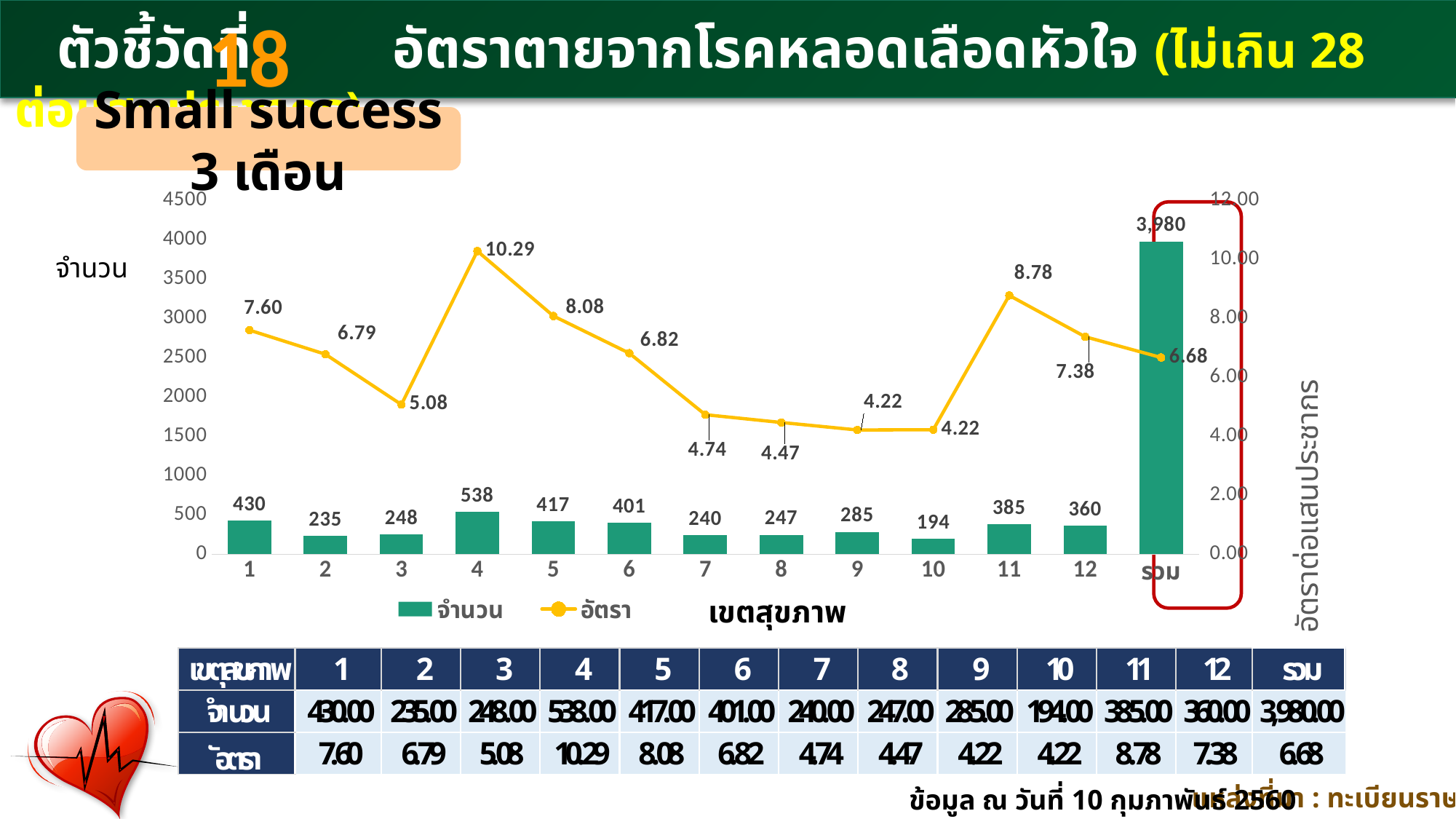
What is the difference in จำนวน between เขตสุขภาพ 4 and เขตสุขภาพ 10? 344 What is the จำนวน value shown for the รวม (total) bar? 3,980 Does the อัตรา line rise or fall from เขตสุขภาพ 4 to เขตสุขภาพ 9? fall Which has a higher อัตรา, เขตสุขภาพ 11 or เขตสุขภาพ 12? เขตสุขภาพ 11 Which เขตสุขภาพ has the highest อัตรา? 4 What is the อัตรา value for รวม? 6.68 How many categories are shown on the x axis, including รวม? 13 What is the อัตรา (rate) value for เขตสุขภาพ 1? 7.60 Among เขตสุขภาพ 1 to 12, which region has the lowest จำนวน? 10 How many series does the legend list? 2 Among เขตสุขภาพ 1 to 12, which region has the highest จำนวน? 4 What is the จำนวน (count) value for เขตสุขภาพ 4? 538